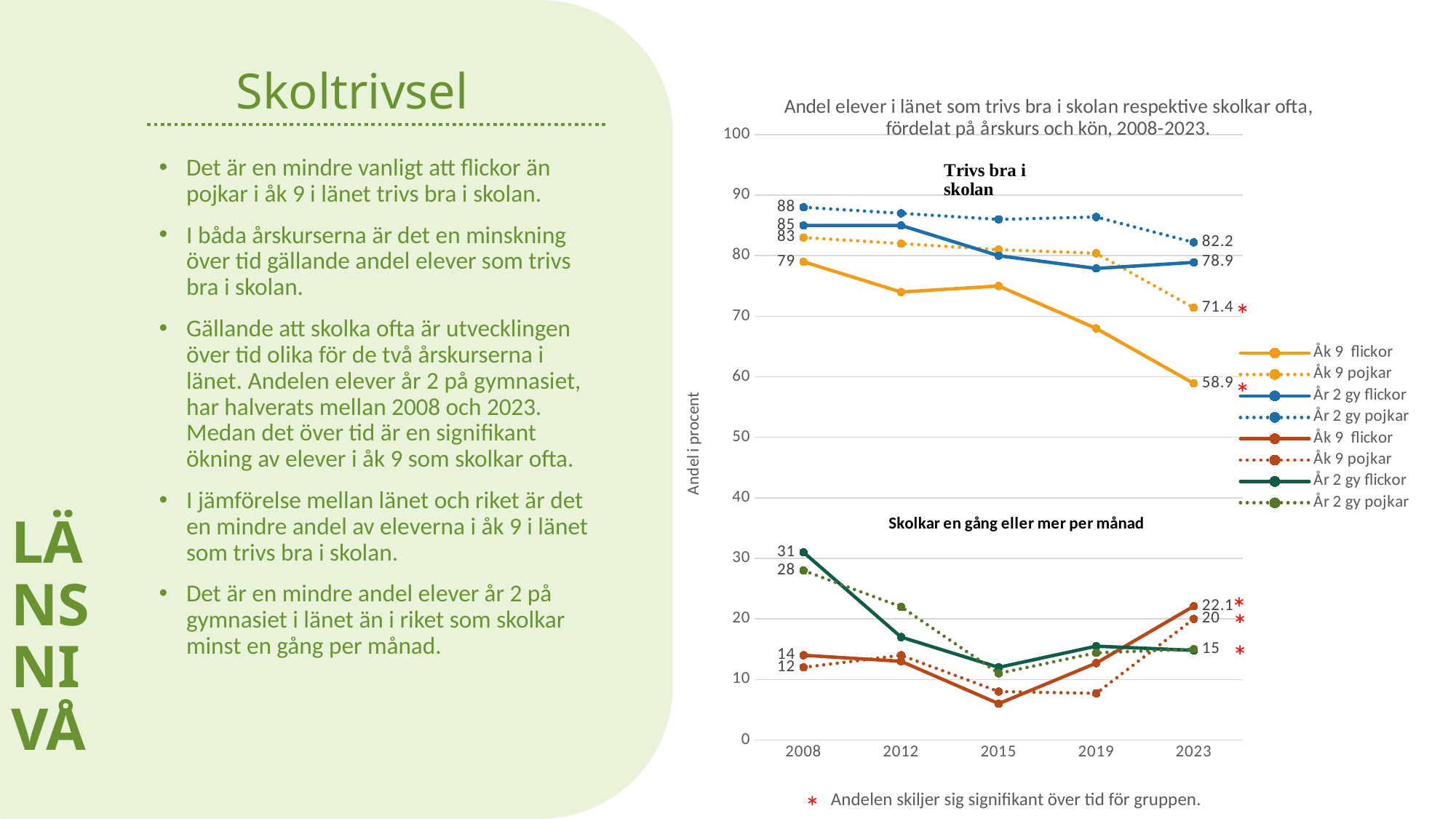
What is the value for År 2 gy pojkar who trivs bra i skolan in 2008? 88 What is the value for År 2 gy flickor who skolkar en gång eller mer per månad in 2008? 31 How many series does the legend list? 8 Does the share of Åk 9 flickor who trivs bra i skolan rise or fall from 2008 to 2023? fall What is the value for Åk 9 flickor who skolkar en gång eller mer per månad in 2023? 22.1 What is the value for Åk 9 flickor who trivs bra i skolan in 2023? 58.9 Is the value for Åk 9 flickor who skolkar en gång eller mer per månad in 2015 greater or less than 10? less By how much did the share of Åk 9 flickor who trivs bra i skolan fall from 2008 to 2023? 20.1 What is the value for Åk 9 pojkar who trivs bra i skolan in 2023? 71.4 Which group had the higher share who trivs bra i skolan in 2023, År 2 gy pojkar or År 2 gy flickor? År 2 gy pojkar What kind of chart is shown on the slide? line chart How many years are shown on the x axis? 5